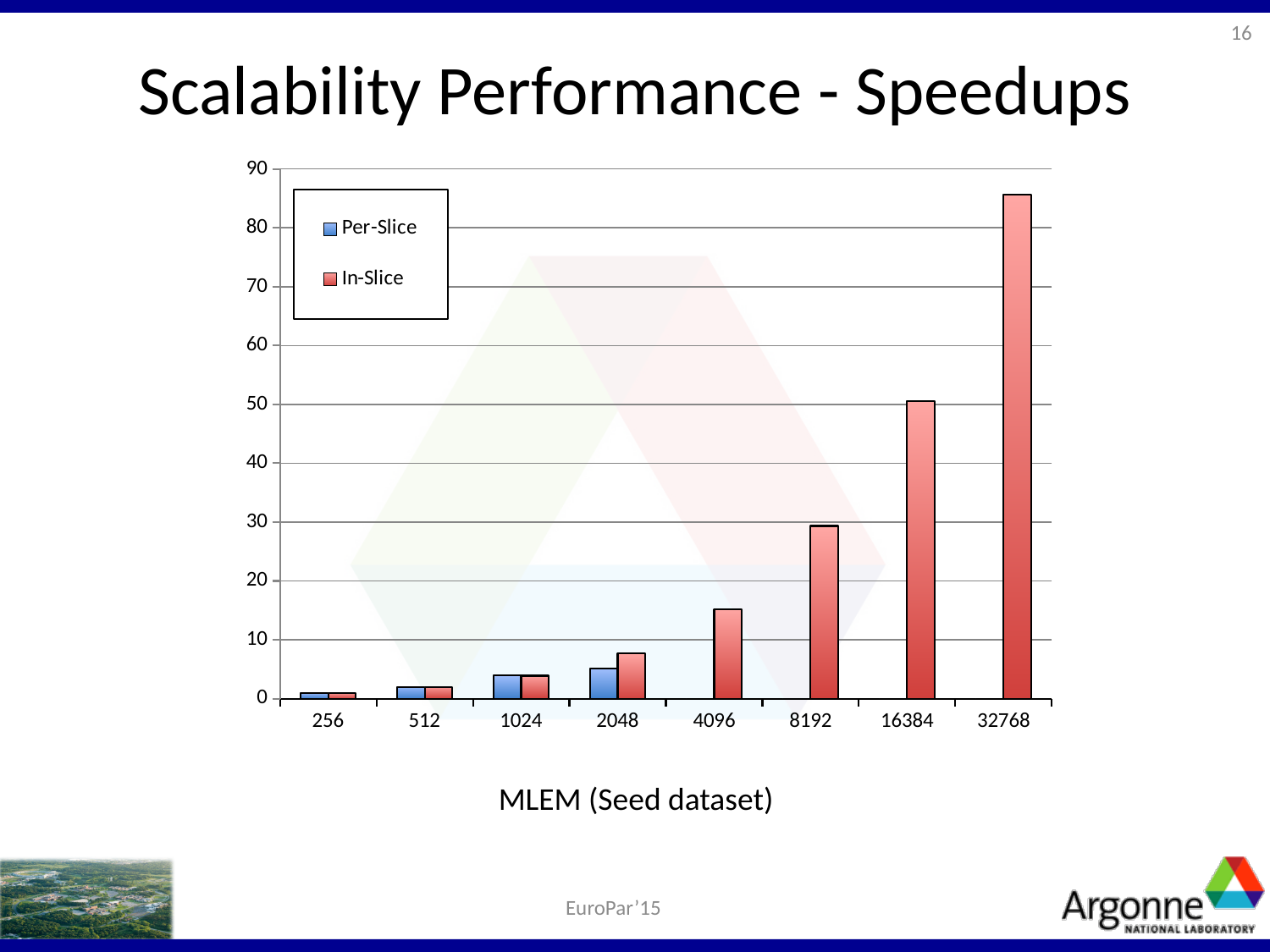
Do the In-Slice values rise or fall as the x-axis categories increase from 256 to 32768? rise How many categories are shown along the x axis? 8 Is the In-Slice value for 2048 greater or less than 10? less Is the In-Slice value for 32768 greater or less than 80? greater For which category is the In-Slice speedup lowest? 256 At 2048, which series has the larger speedup, Per-Slice or In-Slice? In-Slice What is the title of the slide containing the chart? Scalability Performance - Speedups What kind of chart is shown on the slide? bar chart Is the In-Slice value for 4096 greater or less than 20? less How many series does the legend list? 2 For which category is the In-Slice speedup highest? 32768